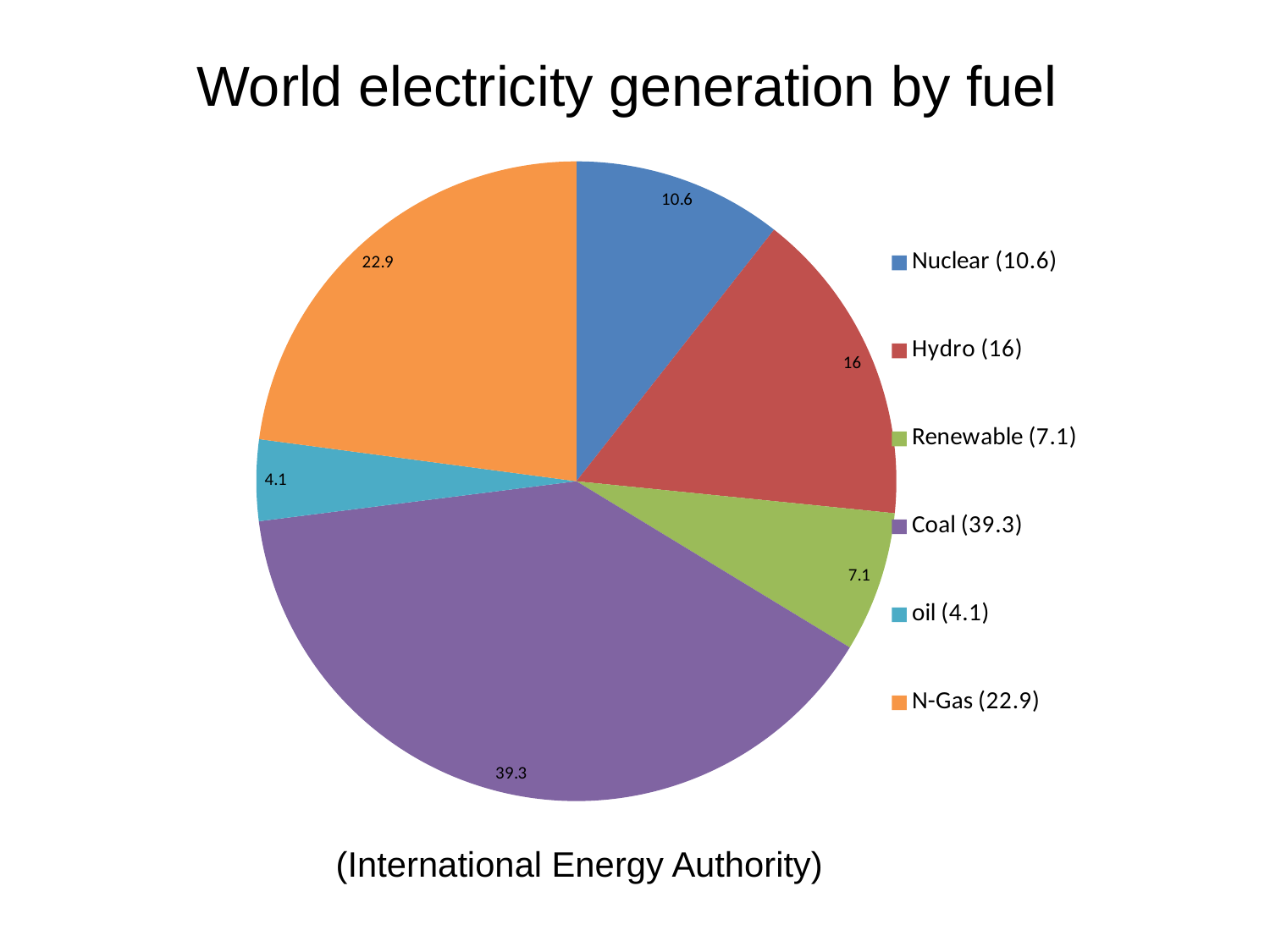
What is the value for Hydro? 16 What is the title of the chart? World electricity generation by fuel How many fuel categories are shown in the pie chart? 6 What is the difference between the values for Coal and N-Gas? 16.4 What is the value for Renewable? 7.1 What is the value for N-Gas? 22.9 Which fuel has the smallest slice of the pie? oil What is the value for Coal? 39.3 What is the difference between the values for Hydro and Nuclear? 5.4 Which fuel has the largest slice of the pie? Coal Which is larger, the value for Nuclear or the value for Renewable? Nuclear What type of chart is shown on the slide? pie chart